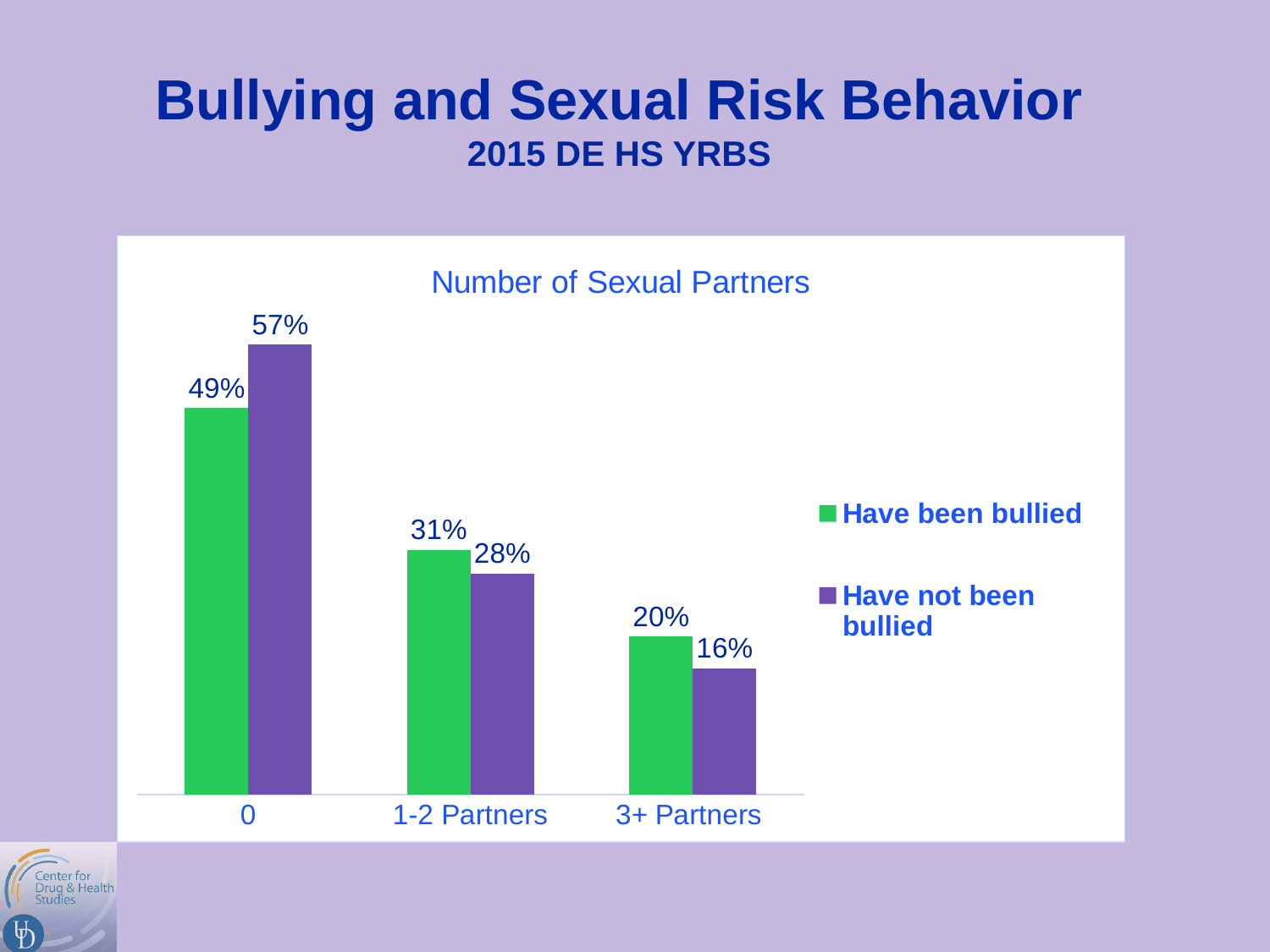
What is the value for 'Have been bullied' in the 1-2 Partners category? 31% Which category has the lowest value for the 'Have been bullied' series? 3+ Partners What is the value for 'Have not been bullied' in the 3+ Partners category? 16% In the 1-2 Partners category, which series has the larger value? Have been bullied What percentage of students who have been bullied reported 0 sexual partners? 49% Which category has the highest value for the 'Have not been bullied' series? 0 What percentage of students who have not been bullied reported 0 sexual partners? 57% How many categories are shown on the x axis? 3 How many series does the legend list? 2 What is the difference between 'Have not been bullied' and 'Have been bullied' in the 0 partners category? 8% What type of chart is shown on the slide? Bar chart What is the difference between 'Have been bullied' and 'Have not been bullied' in the 3+ Partners category? 4%